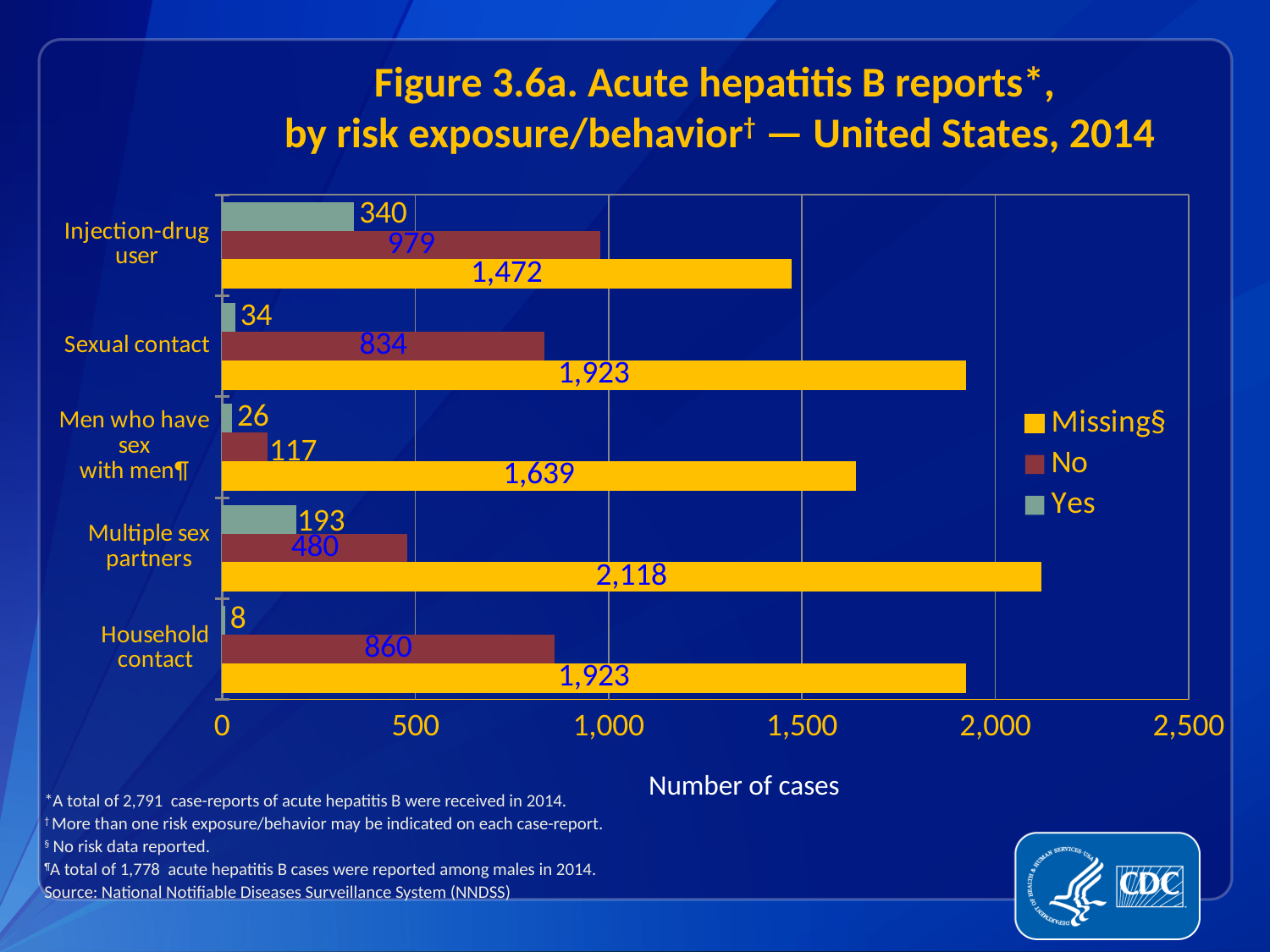
Which is larger, the 'Missing' value for Injection-drug user or for Men who have sex with men? Men who have sex with men How many risk exposure/behavior categories are shown on the chart? 5 Which category has the lowest 'Yes' value? Household contact What is the 'No' value for Household contact? 860 Which category has the lowest 'No' value? Men who have sex with men How many series does the legend list? 3 Which category has the highest 'Yes' value? Injection-drug user What is the 'Yes' value for Injection-drug user? 340 What is the 'Missing' value for Multiple sex partners? 2,118 What is the difference between the 'No' values for Injection-drug user and Multiple sex partners? 499 What kind of chart is shown on the slide? bar chart What is the label of the x axis? Number of cases